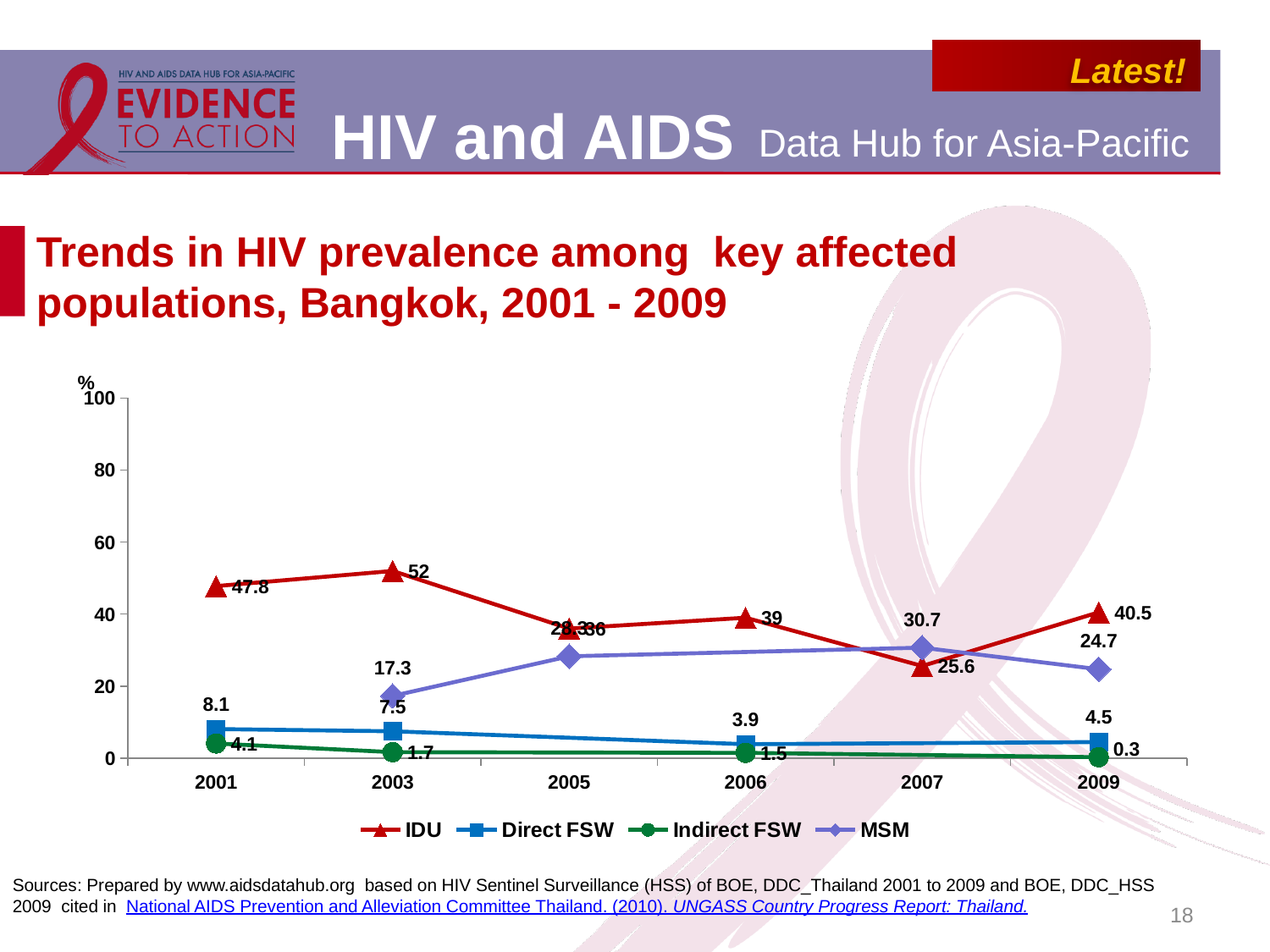
How many series does the legend list? 4 What kind of chart is shown on the slide? Line chart In which year is the HIV prevalence among IDU lowest? 2007 What is the HIV prevalence among IDU in 2003? 52 By how much did HIV prevalence among IDU change from 2001 to 2003? 4.2 In which year is the HIV prevalence among IDU highest? 2003 In 2009, which group has the higher HIV prevalence, IDU or MSM? IDU What is the HIV prevalence among Indirect FSW in 2009? 0.3 Does the HIV prevalence among Indirect FSW rise or fall from 2001 to 2009? Fall What is the HIV prevalence among MSM in 2007? 30.7 What is the HIV prevalence among Direct FSW in 2001? 8.1 What is the HIV prevalence among IDU in 2001? 47.8